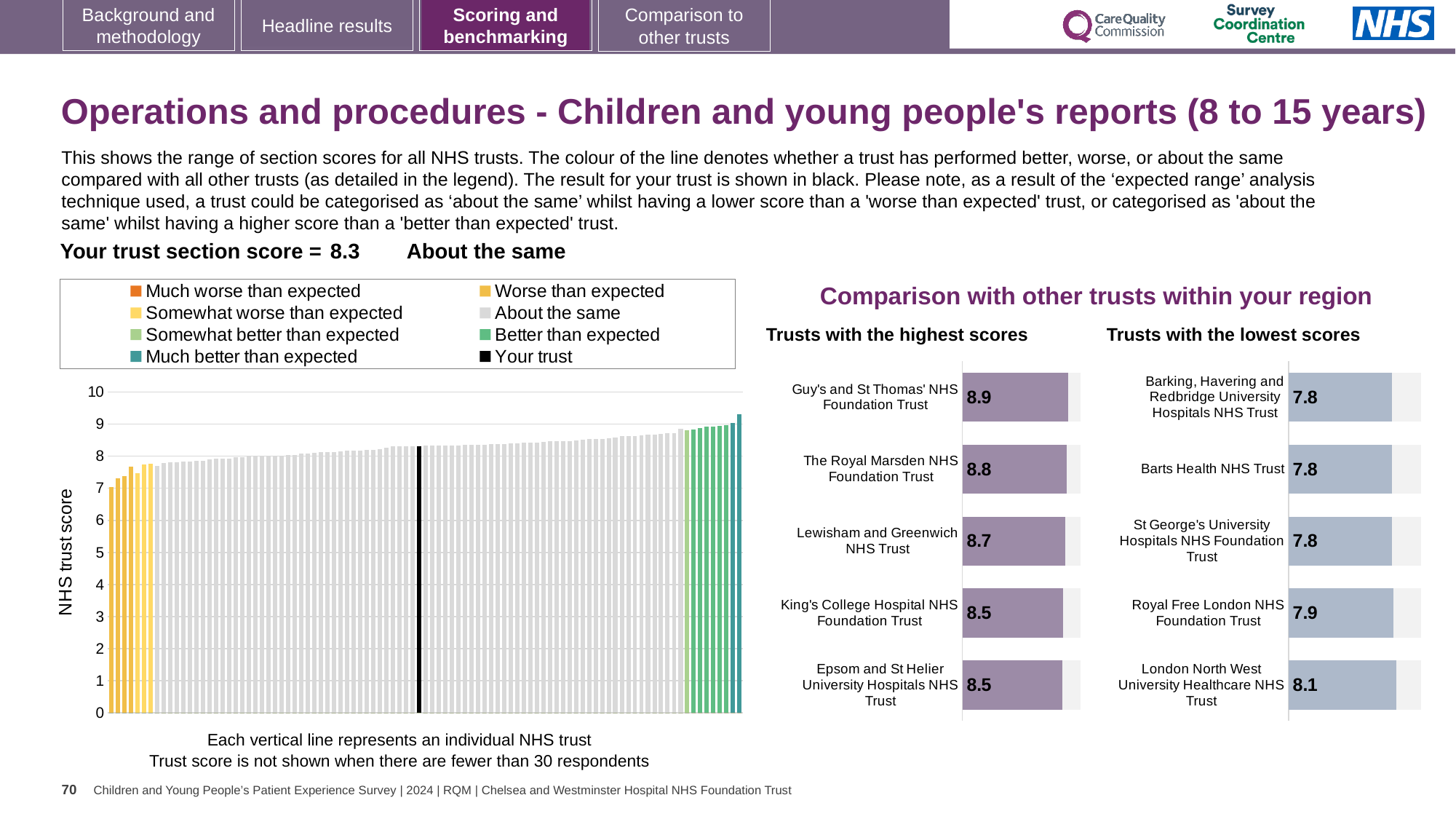
In the 'Trusts with the lowest scores' chart, which has the larger score: Royal Free London NHS Foundation Trust or Barts Health NHS Trust? Royal Free London NHS Foundation Trust In the NHS trust score chart, do the bar values rise or fall from left to right? rise How many entries does the legend above the NHS trust score chart list? 8 How many trusts are shown in the 'Trusts with the highest scores' chart? 5 In the NHS trust score chart, is the value of the black 'Your trust' bar greater or less than 8? greater In the 'Trusts with the highest scores' chart, what is the difference between the scores of Guy's and St Thomas' NHS Foundation Trust and Lewisham and Greenwich NHS Trust? 0.2 What kind of chart is the large chart on the left showing NHS trust scores? bar chart What is the section score for your trust shown on the slide? 8.3 In the 'Trusts with the highest scores' chart, what is the score for Guy's and St Thomas' NHS Foundation Trust? 8.9 In the 'Trusts with the lowest scores' chart, what is the score for London North West University Healthcare NHS Trust? 8.1 In the 'Trusts with the highest scores' chart, which trust has the highest score? Guy's and St Thomas' NHS Foundation Trust In the 'Trusts with the lowest scores' chart, which trust has the highest score? London North West University Healthcare NHS Trust